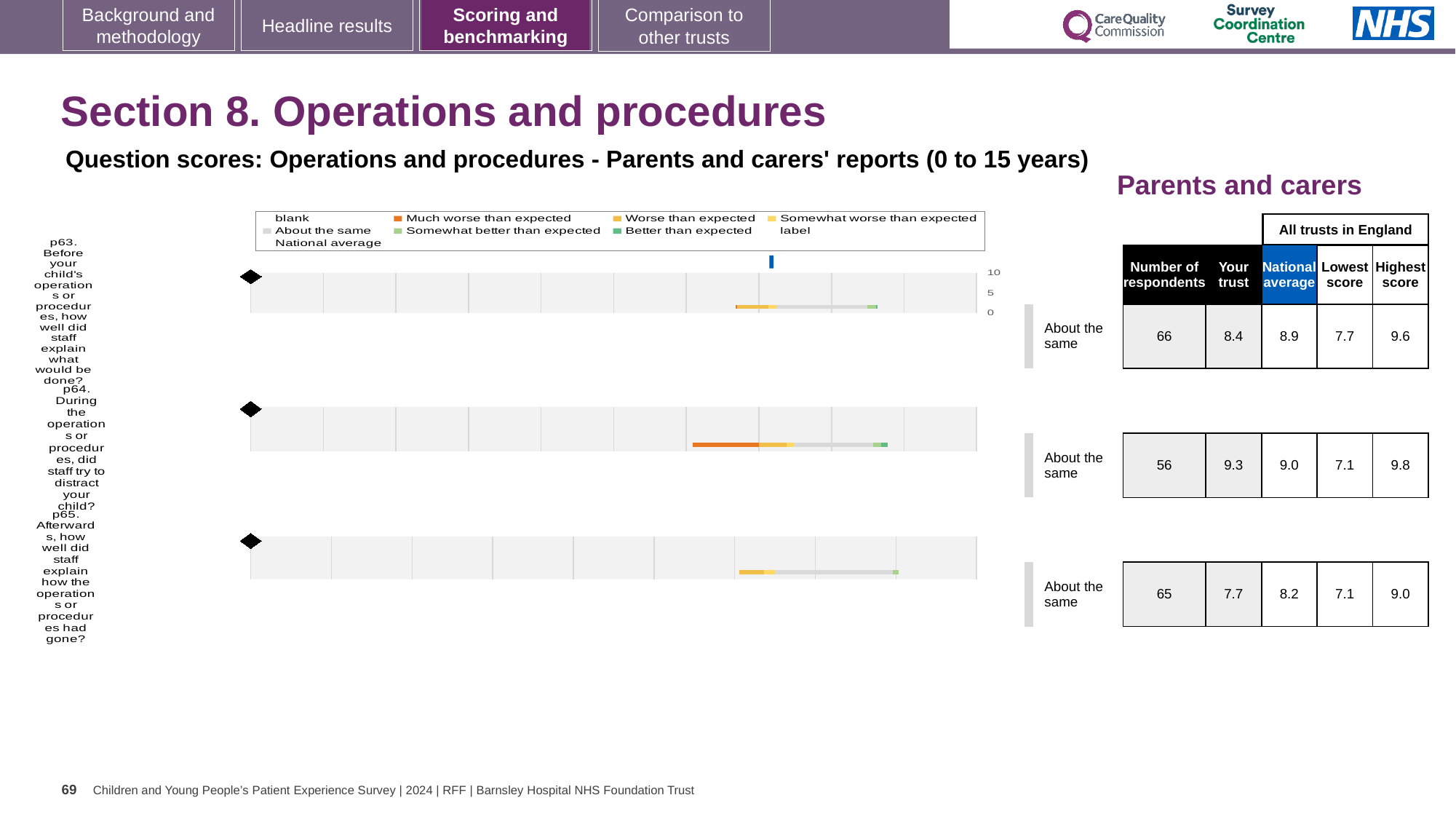
Which question has the highest 'Your trust' score in the table? p64 What benchmark category is shown next to each of the three question charts? About the same What is the highest score across all trusts in England for p64? 9.8 For p64, what is the difference between the 'Your trust' score and the national average? 0.3 How many question charts are shown on the slide? 3 According to the table, how many respondents answered p65 (Afterwards, how well did staff explain how the operations or procedures had gone?)? 65 According to the table, what is the national average for p63 (Before your child's operations or procedures, how well did staff explain what would be done?)? 8.9 According to the table, what is the 'Your trust' score for p64 (During the operations or procedures, did staff try to distract your child?)? 9.3 Which question has the lowest 'Your trust' score in the table? p65 For p63, which is larger: the 'Your trust' score or the national average? National average What colour does the legend use for 'Much worse than expected'? Orange What kind of chart is used for each question (p63, p64, p65)? bar chart